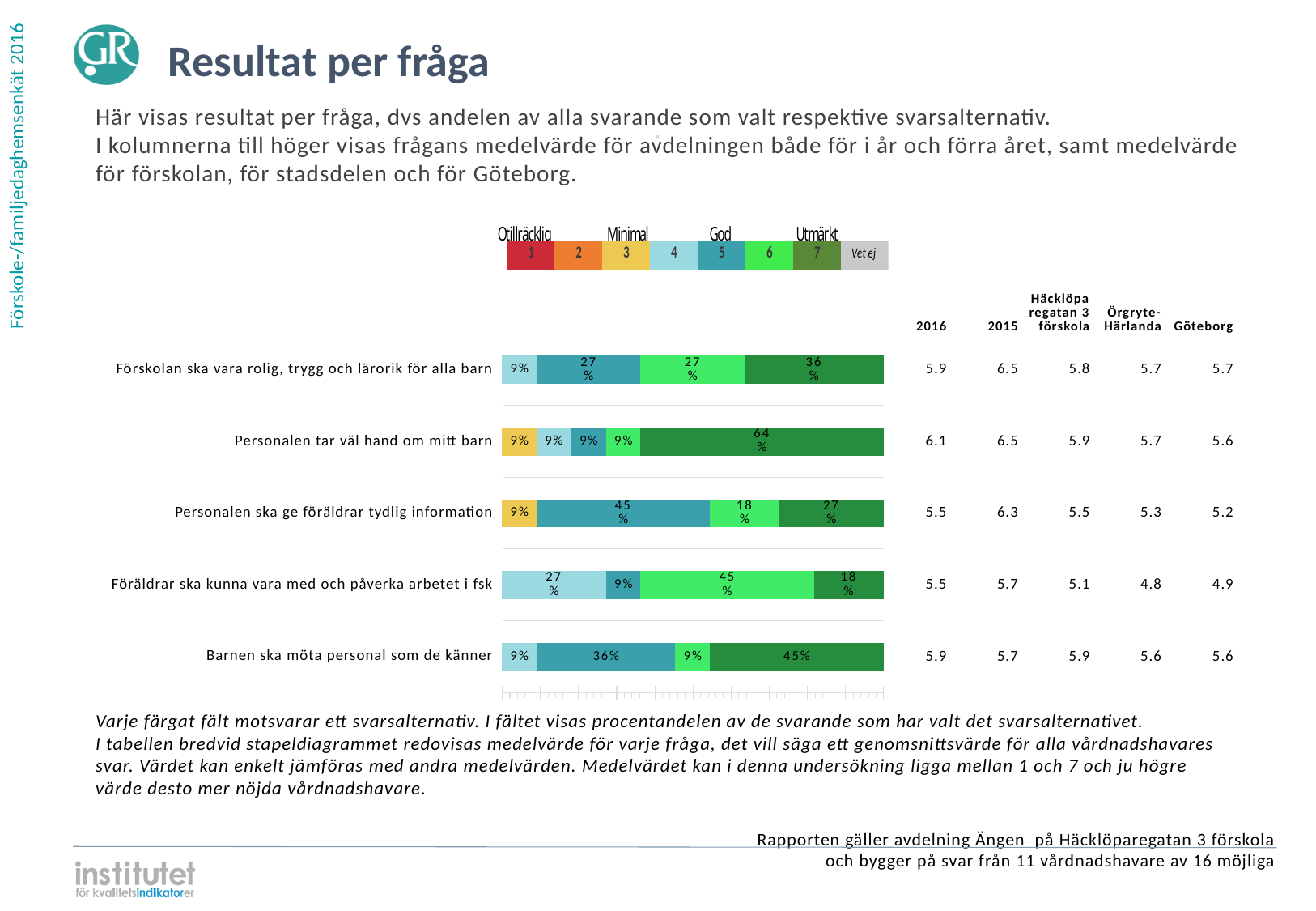
Which question has the lowest Göteborg mean value? Föräldrar ska kunna vara med och påverka arbetet i fsk What percentage is shown for the light blue (option 4) segment of "Föräldrar ska kunna vara med och påverka arbetet i fsk"? 27% What is the difference between the 2015 and 2016 mean values for "Förskolan ska vara rolig, trygg och lärorik för alla barn"? 0.6 What percentage of respondents chose option 5 for "Barnen ska möta personal som de känner"? 36% What is the 2016 mean value for "Personalen ska ge föräldrar tydlig information"? 5.5 What percentage of respondents chose option 7 (dark green) for "Personalen tar väl hand om mitt barn"? 64% Which question has the largest dark green (option 7) segment? Personalen tar väl hand om mitt barn For "Föräldrar ska kunna vara med och påverka arbetet i fsk", which is larger: the Göteborg mean or the Örgryte-Härlanda mean? Göteborg What is the total of the percentage segments in the bar for "Personalen tar väl hand om mitt barn"? 100% How many questions (categories) are shown in the bar chart? 5 What kind of chart is used to show the answer distribution per question? Stacked bar chart What label does the grey box in the legend carry? Vet ej